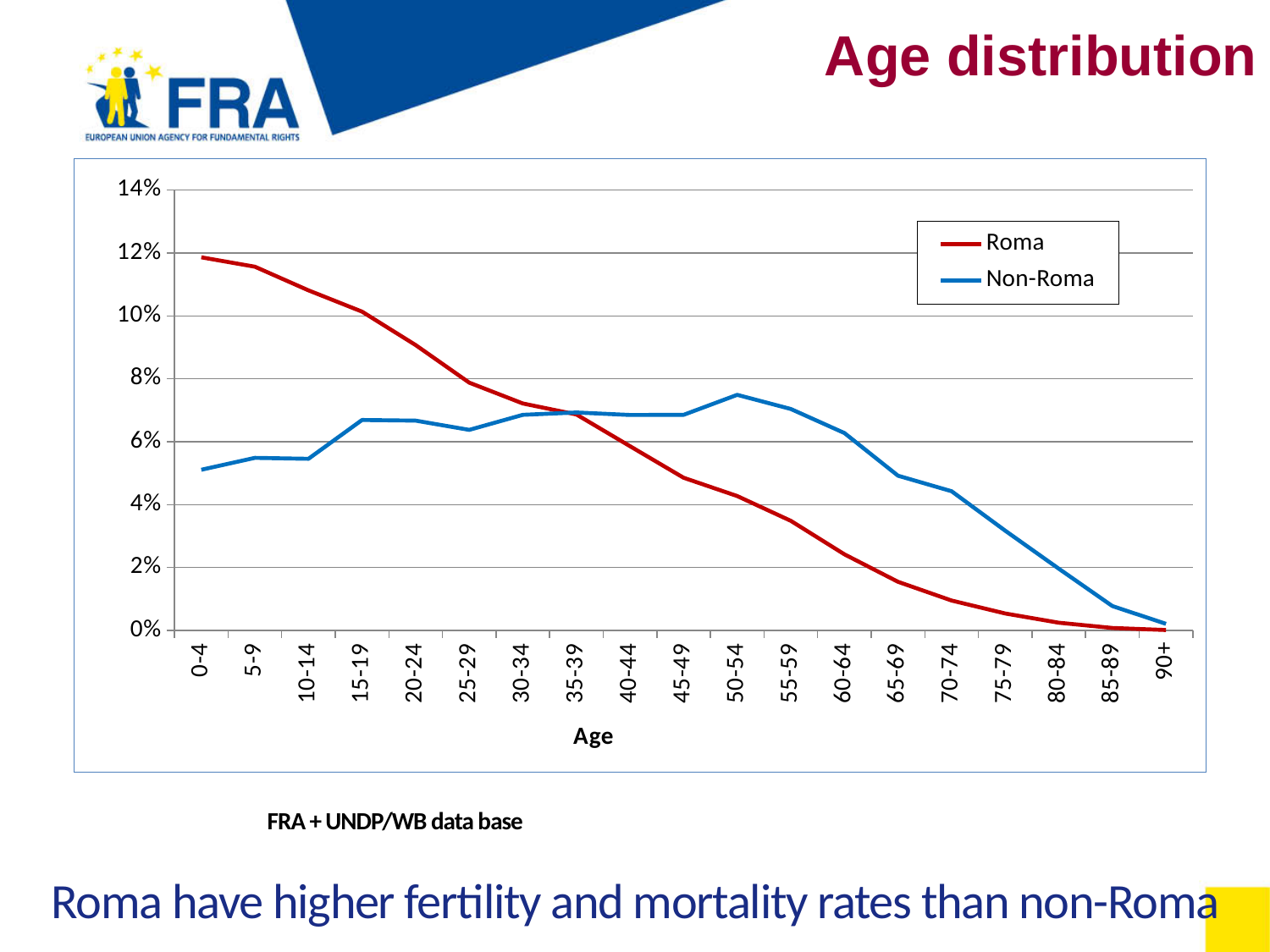
Which age group has the highest value for the Roma series? 0-4 Which age group has the lowest value for the Non-Roma series? 90+ How many series does the legend list? 2 For the 60-64 age group, which series has the larger value, Roma or Non-Roma? Non-Roma Is the Roma value for the 0-4 age group greater or less than 10%? greater Which age group has the highest value for the Non-Roma series? 50-54 How many age groups are shown on the x axis? 19 Is the Roma value for the 45-49 age group greater or less than 4%? greater Does the Roma series generally rise or fall as age increases along the x axis? Fall What colour is the line for the Roma series? Red Is the Non-Roma value for the 0-4 age group greater or less than 6%? less What kind of chart is shown on the slide? Line chart